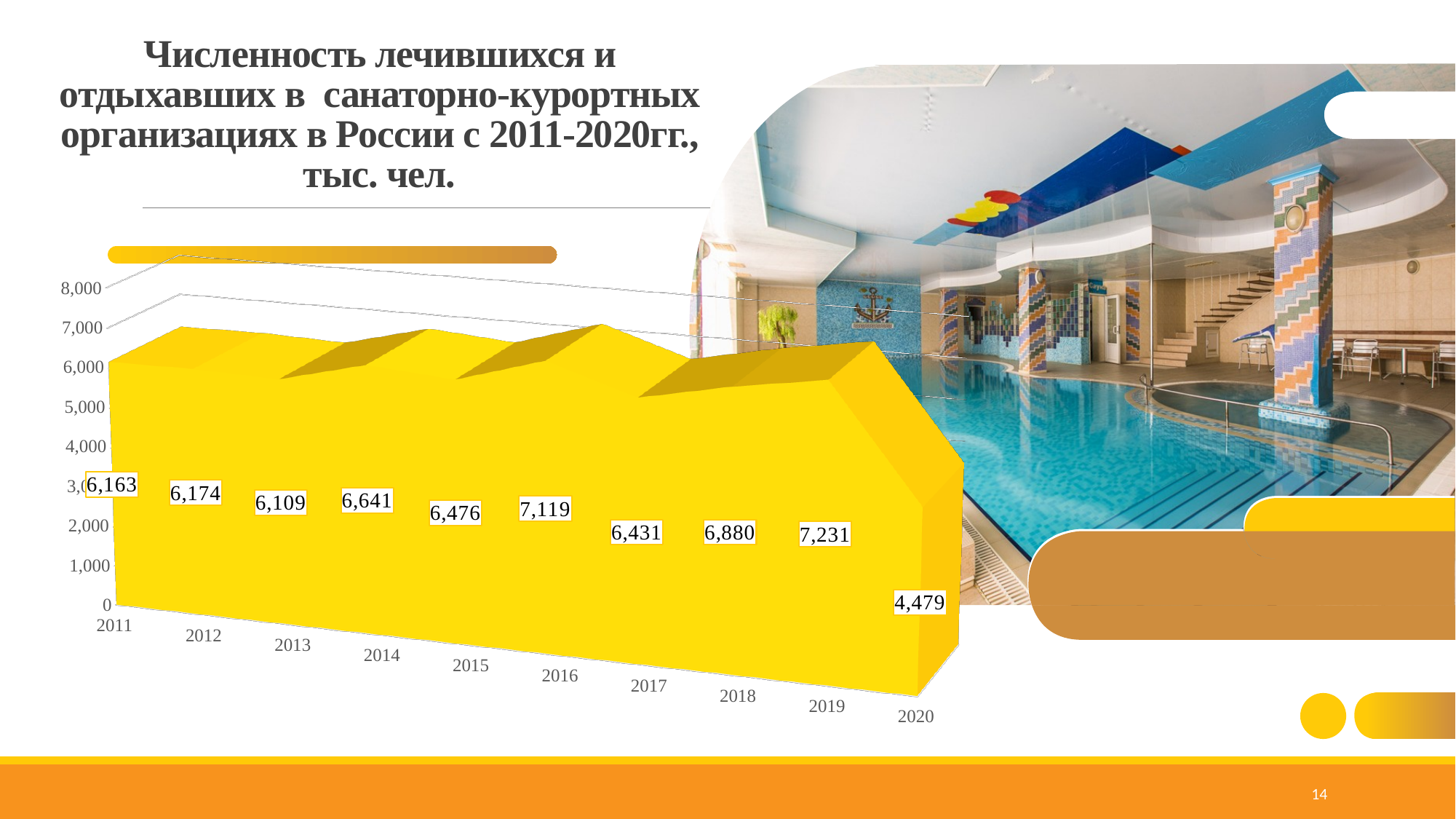
Is the value for 2019 greater or less than 7,000? greater Which year has the lowest value? 2020 What kind of chart is shown on the slide? 3D area chart Which year has the highest value? 2019 How many years are plotted on the chart? 10 What is the value for 2013? 6,109 What is the difference between the values for 2019 and 2020? 2,752 What unit of measurement is stated in the chart title? тыс. чел. What is the difference between the values for 2014 and 2015? 165 What is the value for 2020? 4,479 What is the value for 2016? 7,119 Which is larger, the value for 2018 or the value for 2017? 2018